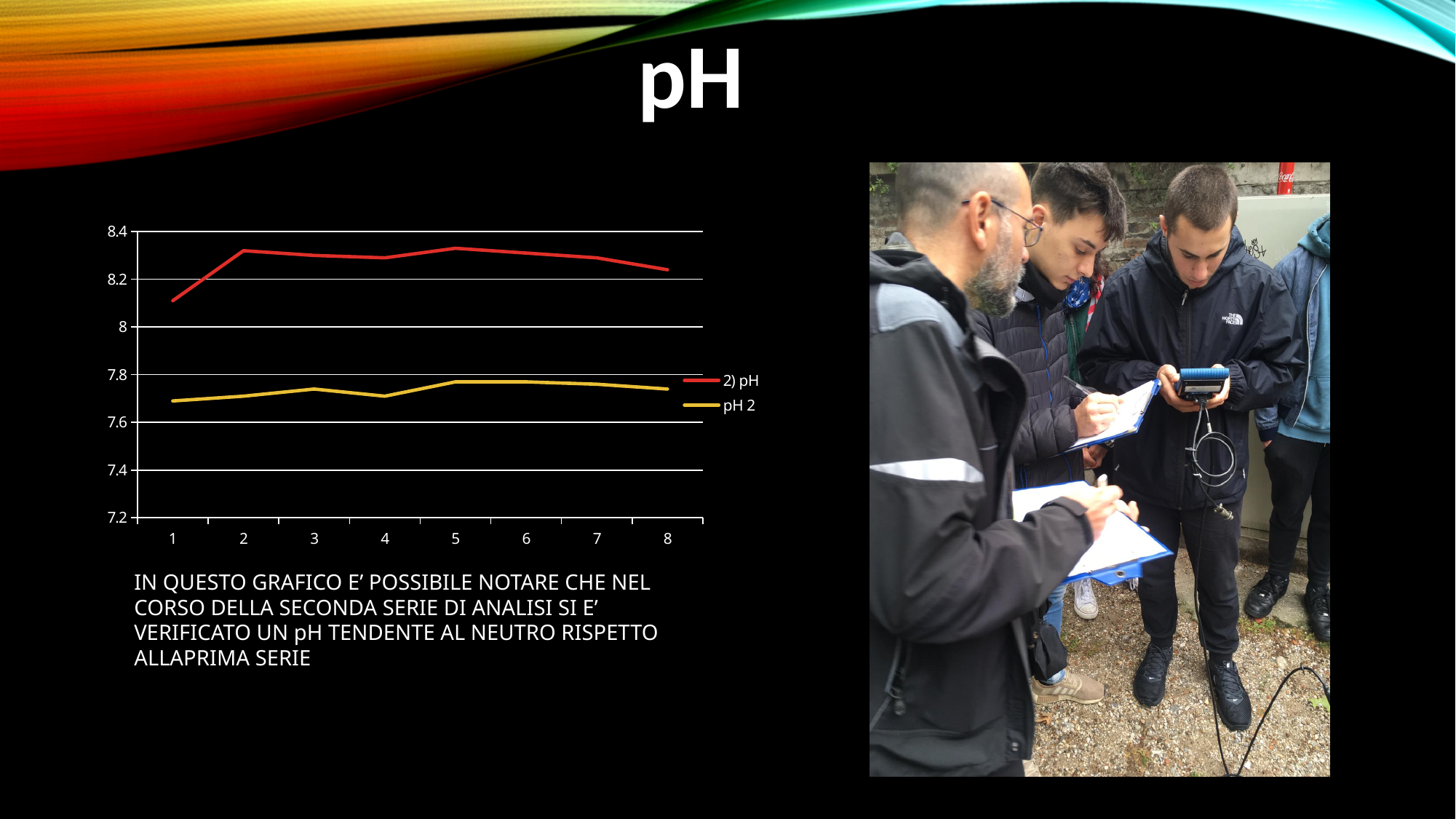
At which point does the "2) pH" series reach its lowest value? 1 What colour is the line for the series "pH 2"? yellow At point 4, which series has the larger value, "2) pH" or "pH 2"? 2) pH Is the value of "2) pH" at point 1 greater or less than 8? greater Is the value of "pH 2" at point 5 greater or less than 7.8? less Which series is plotted in red? 2) pH What kind of chart is shown on the slide? line chart Is the value of "2) pH" at point 2 greater or less than 8.2? greater How many points are plotted along the x axis for each series? 8 Does the "2) pH" series rise or fall from point 5 to point 8? fall How many series does the chart legend list? 2